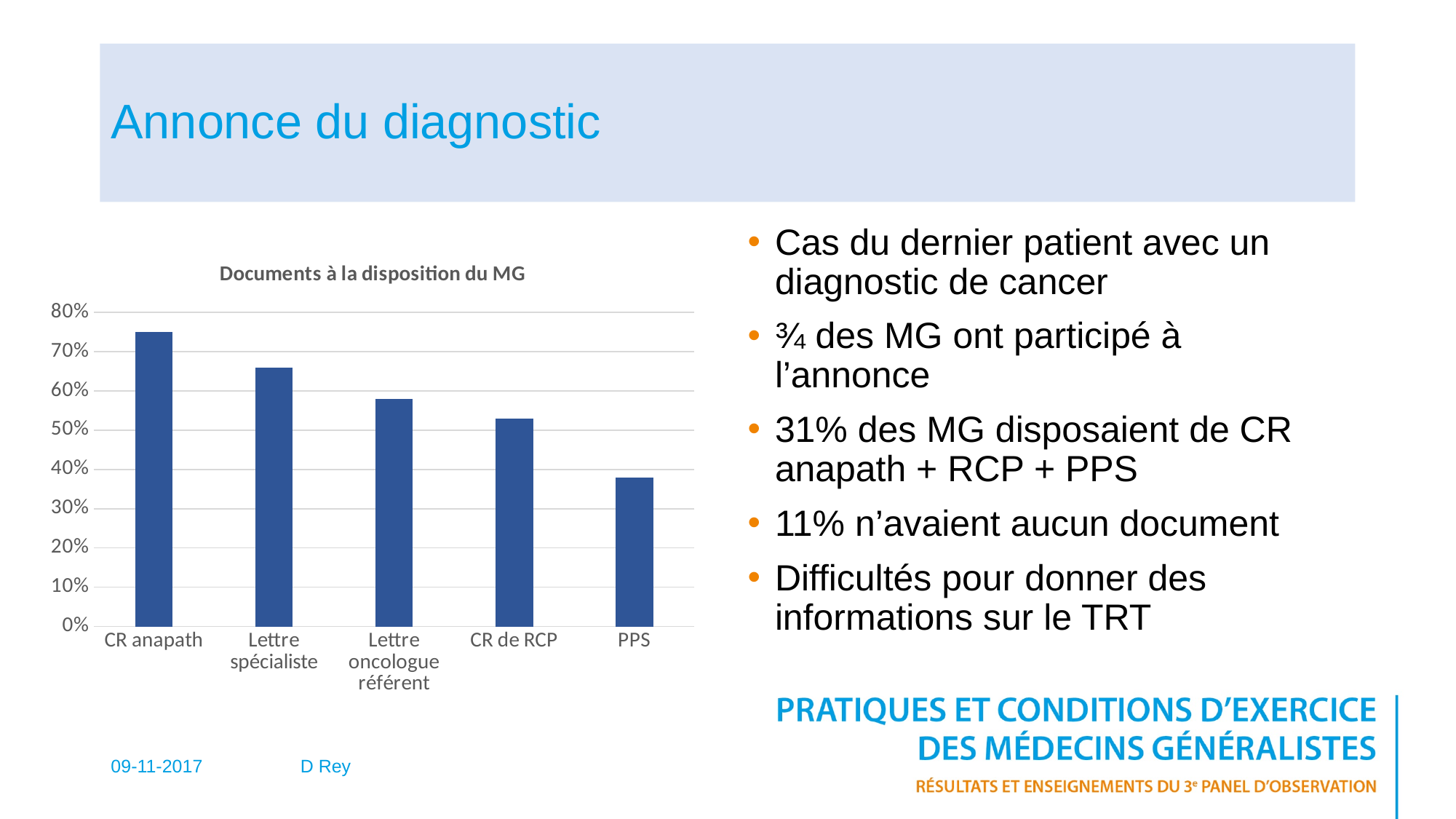
What is the highest value shown on the y axis of the chart? 80% What kind of chart is shown on the slide? bar chart Is the value for CR de RCP greater or less than 50%? greater Which category has the highest value in the chart? CR anapath Which is larger, the value for Lettre spécialiste or the value for CR de RCP? Lettre spécialiste Do the values rise or fall from left to right across the categories? fall Is the value for CR anapath greater or less than 70%? greater Which category has the lowest value in the chart? PPS How many categories are shown on the x axis of the chart? 5 Is the value for Lettre oncologue référent greater or less than 60%? less What is the title of the chart? Documents à la disposition du MG